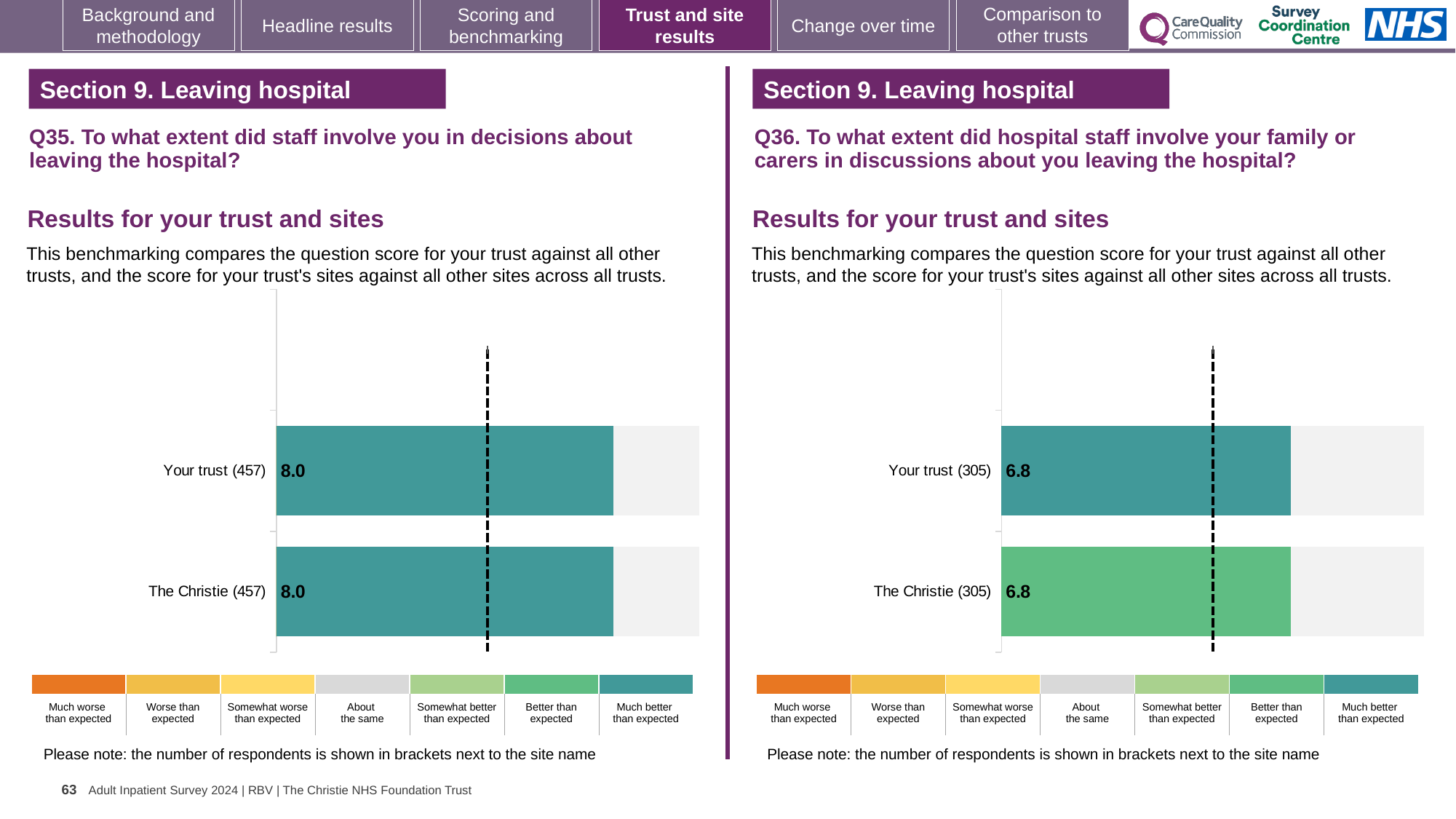
In the Q36 chart (right), what is the score for Your trust? 6.8 In the Q35 chart (left), what is the score for Your trust? 8.0 In the Q36 chart (right), how many respondents are shown in brackets for The Christie? 305 In the Q35 chart (left), which benchmark category does the colour of the Your trust bar correspond to? Much better than expected In the Q35 chart (left), how many respondents are shown in brackets for Your trust? 457 What kind of chart is the Q36 chart (right)? Bar chart In the Q35 chart (left), what is the score for The Christie? 8.0 In the Q35 chart (left), what is the difference between the score for Your trust and the score for The Christie? 0.0 In the Q36 chart (right), what is the difference between the score for Your trust and the score for The Christie? 0.0 In the Q36 chart (right), what is the score for The Christie? 6.8 In the Q36 chart (right), which benchmark category does the colour of The Christie bar correspond to? Better than expected How many bars are plotted in the Q35 chart (left)? 2